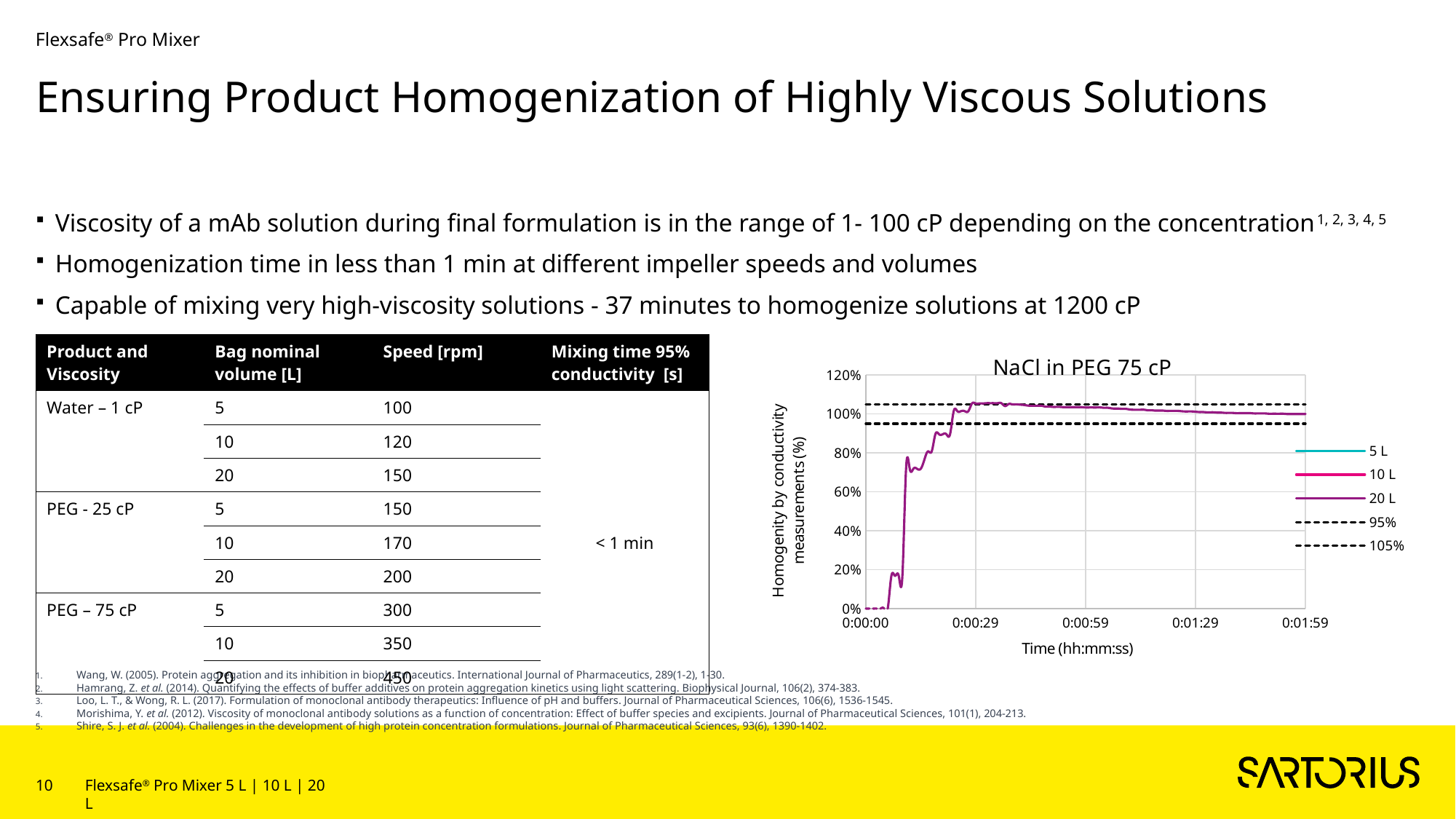
Which legend entry is drawn in cyan? 5 L Is the homogeneity value at 0:01:59 greater or less than 60%? greater What is the title of the chart? NaCl in PEG 75 cP What is the label of the x axis of the chart? Time (hh:mm:ss) Is the homogeneity value at 0:00:59 greater or less than 120%? less What is the highest value shown on the y axis of the chart? 120% What kind of chart is shown on the slide? line chart How many tick labels are shown on the x axis of the chart? 5 How many entries does the chart's legend list? 5 Is the homogeneity value at 0:00:29 greater or less than 80%? greater What is the homogeneity value at time 0:00:00 in the chart? 0% Does the homogeneity value rise or fall between 0:00:00 and 0:00:29? rise